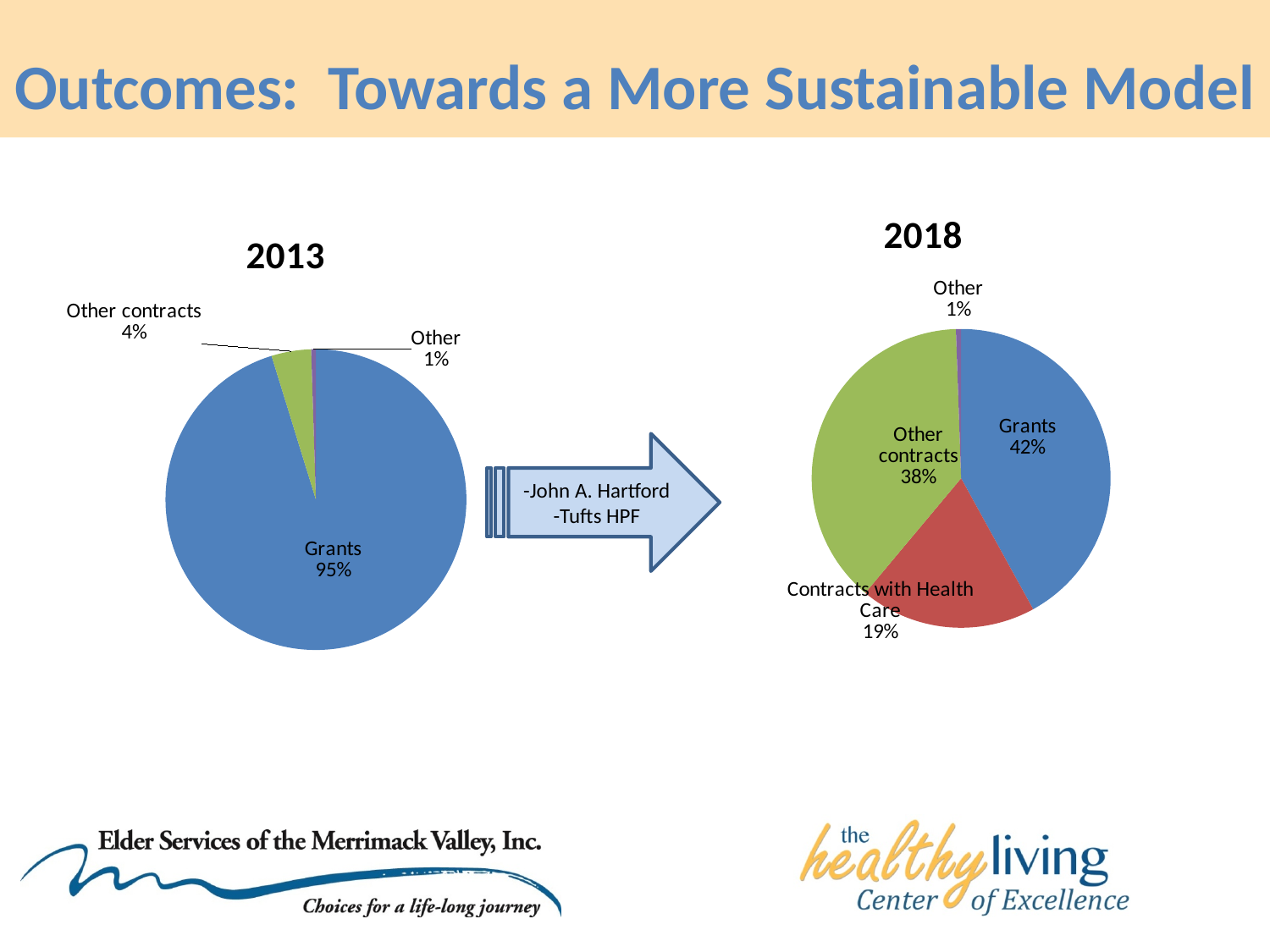
In the 2013 pie chart, how many slices are there? 3 In the 2018 pie chart, how many slices are there? 4 In the 2018 pie chart, what share do Other contracts make up? 38% What is the difference between the Grants share in the 2013 chart and the Grants share in the 2018 chart? 53 percentage points In the 2018 pie chart, which is larger: Other contracts or Contracts with Health Care? Other contracts In the 2018 pie chart, which category has the largest share? Grants In the 2013 pie chart, what share do Other contracts make up? 4% In the 2018 pie chart, what share do Grants make up? 42% In the 2018 pie chart, what share do Contracts with Health Care make up? 19% In the 2013 pie chart, which category has the smallest share? Other What kind of chart is the 2013 chart? Pie chart In the 2013 pie chart, what share do Grants make up? 95%